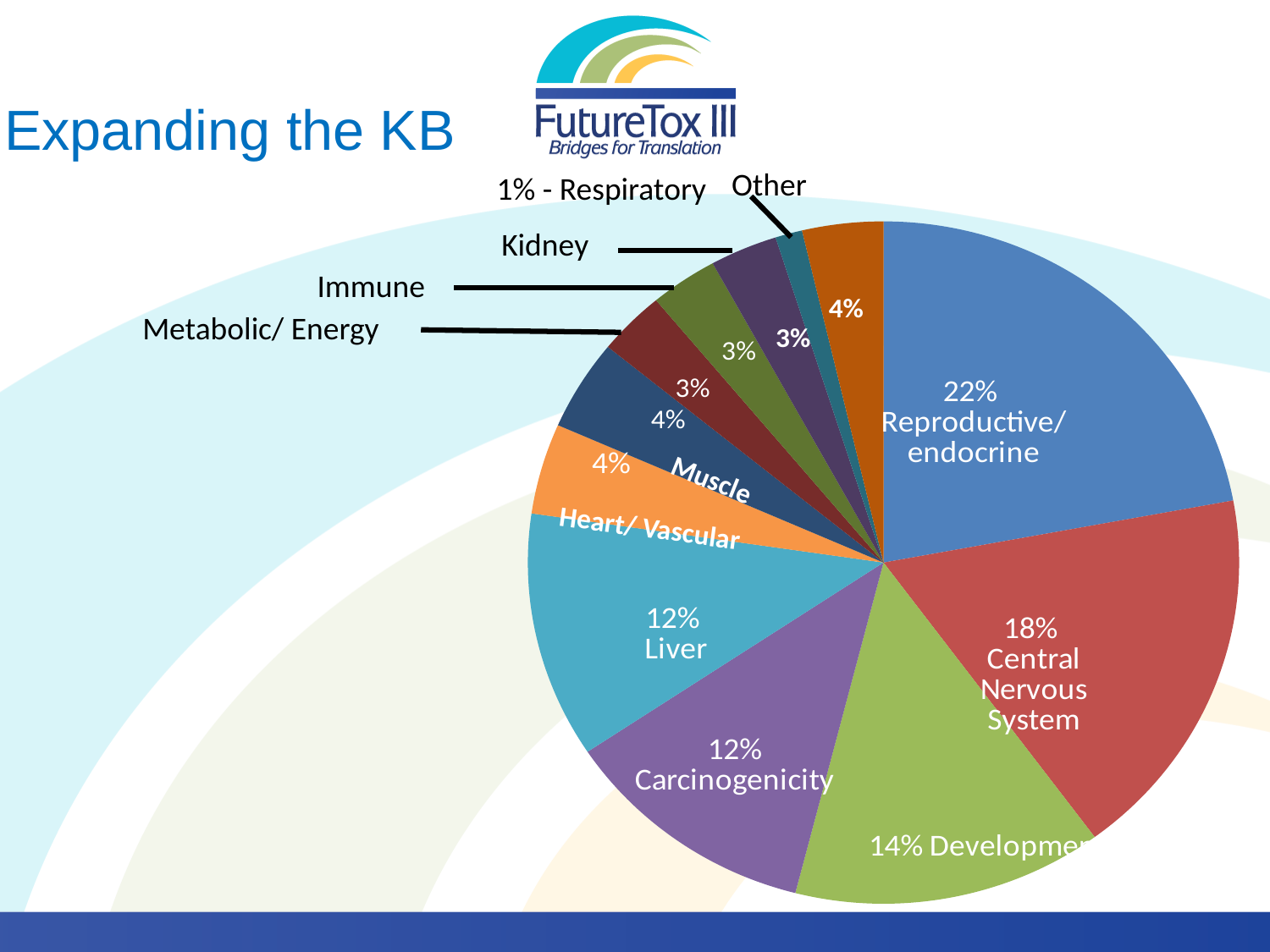
How many percentage points larger is Reproductive/endocrine than Central Nervous System? 4 How many slices does the pie chart have? 12 Which category has the smallest slice of the pie? Respiratory What percentage is shown for Liver? 12% What percentage is shown for Central Nervous System? 18% Which is larger, the Central Nervous System slice or the Development slice? Central Nervous System What percentage is shown for Respiratory? 1% What share of the pie does Reproductive/endocrine account for? 22% What percentage is shown for Carcinogenicity? 12% Which category has the largest slice of the pie? Reproductive/endocrine What kind of chart is shown on the slide? pie chart What is the combined share of the Liver and Carcinogenicity slices? 24%